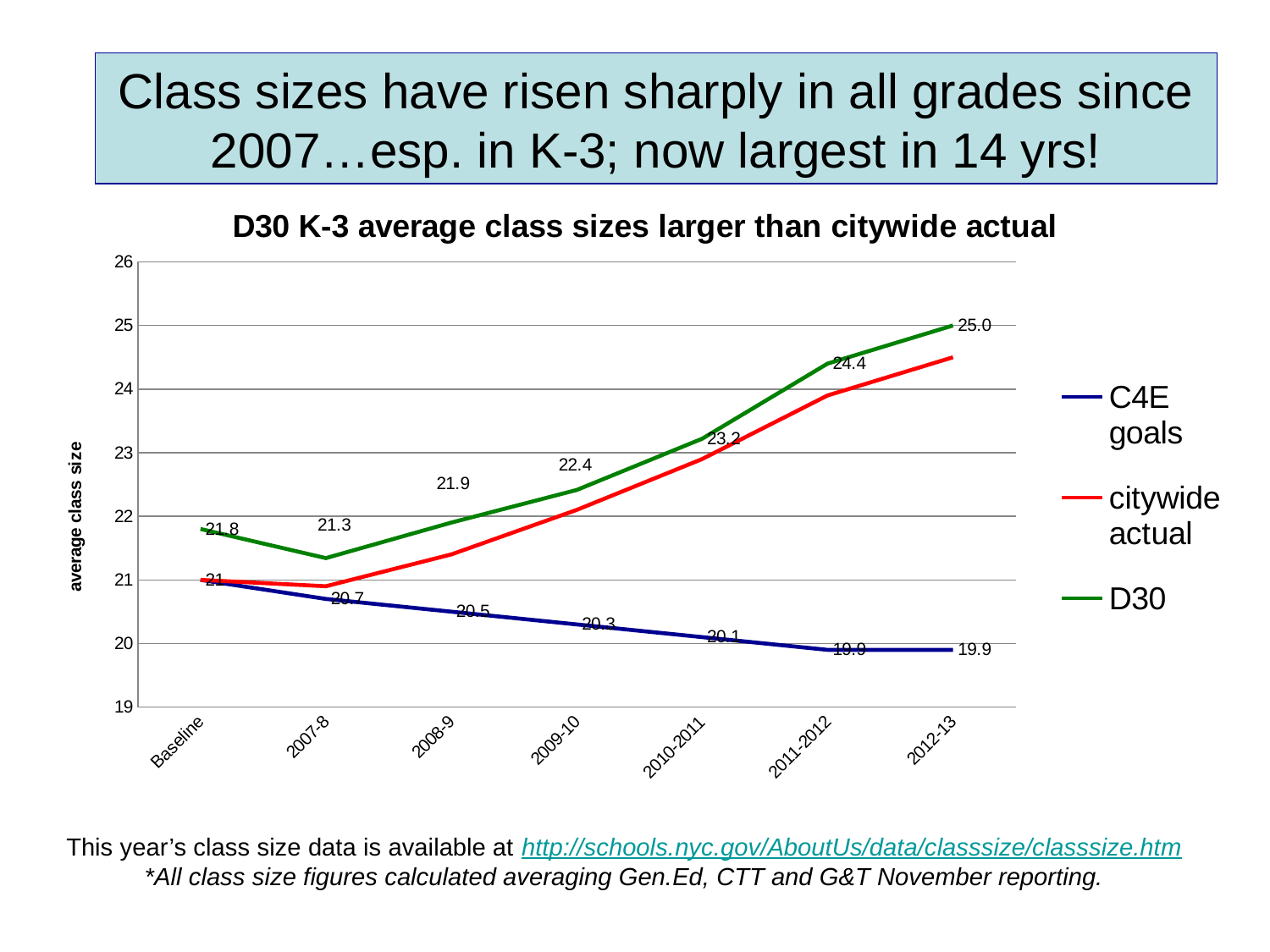
Is the citywide actual value for 2012-13 greater or less than 24? greater How many series does the legend list? 3 In which year is the D30 average class size highest? 2012-13 What is the D30 average class size for 2012-13? 25.0 Does the C4E goals series rise or fall from Baseline to 2012-13? fall In which year is the D30 average class size lowest? 2007-8 By how much did the D30 value increase from Baseline to 2012-13? 3.2 What is the C4E goals value for 2011-2012? 19.9 Is the citywide actual value for 2008-9 greater or less than 22? less What is the D30 value for 2007-8? 21.3 In 2010-2011, which is larger: the D30 value or the C4E goals value? D30 How many time points are shown on the x axis? 7